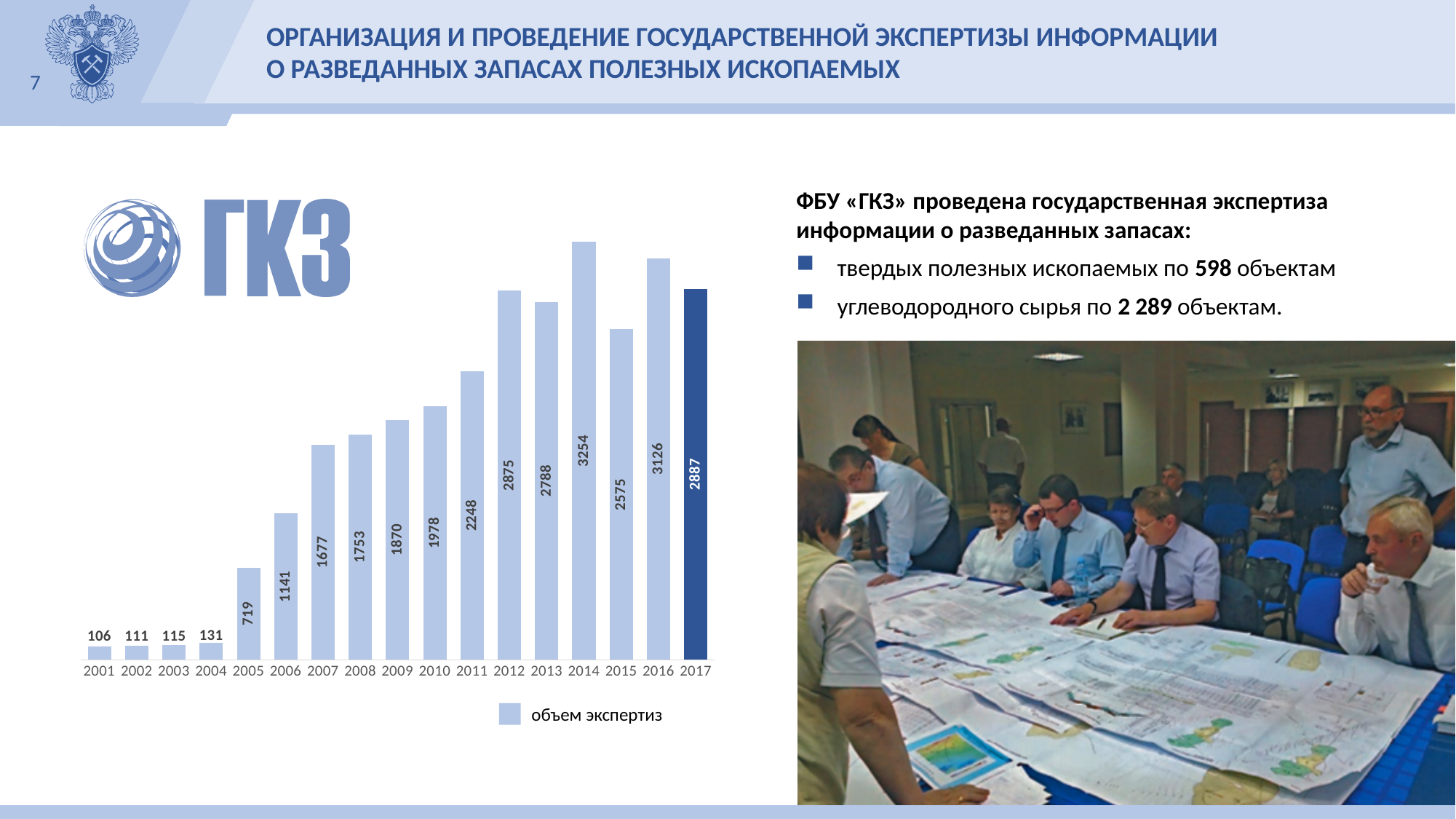
How many years are shown on the x axis? 17 What is the difference between the values for 2016 and 2015? 551 What kind of chart is shown on the slide? bar chart Do the values generally rise or fall from 2001 to 2014? rise Which year has the highest value? 2014 What is the value for 2017? 2887 What is the legend entry of the chart? объем экспертиз Which year has the lowest value? 2001 What is the value for 2005? 719 How many series does the legend list? 1 Which is larger, the value for 2012 or the value for 2013? 2012 What is the value for 2014? 3254